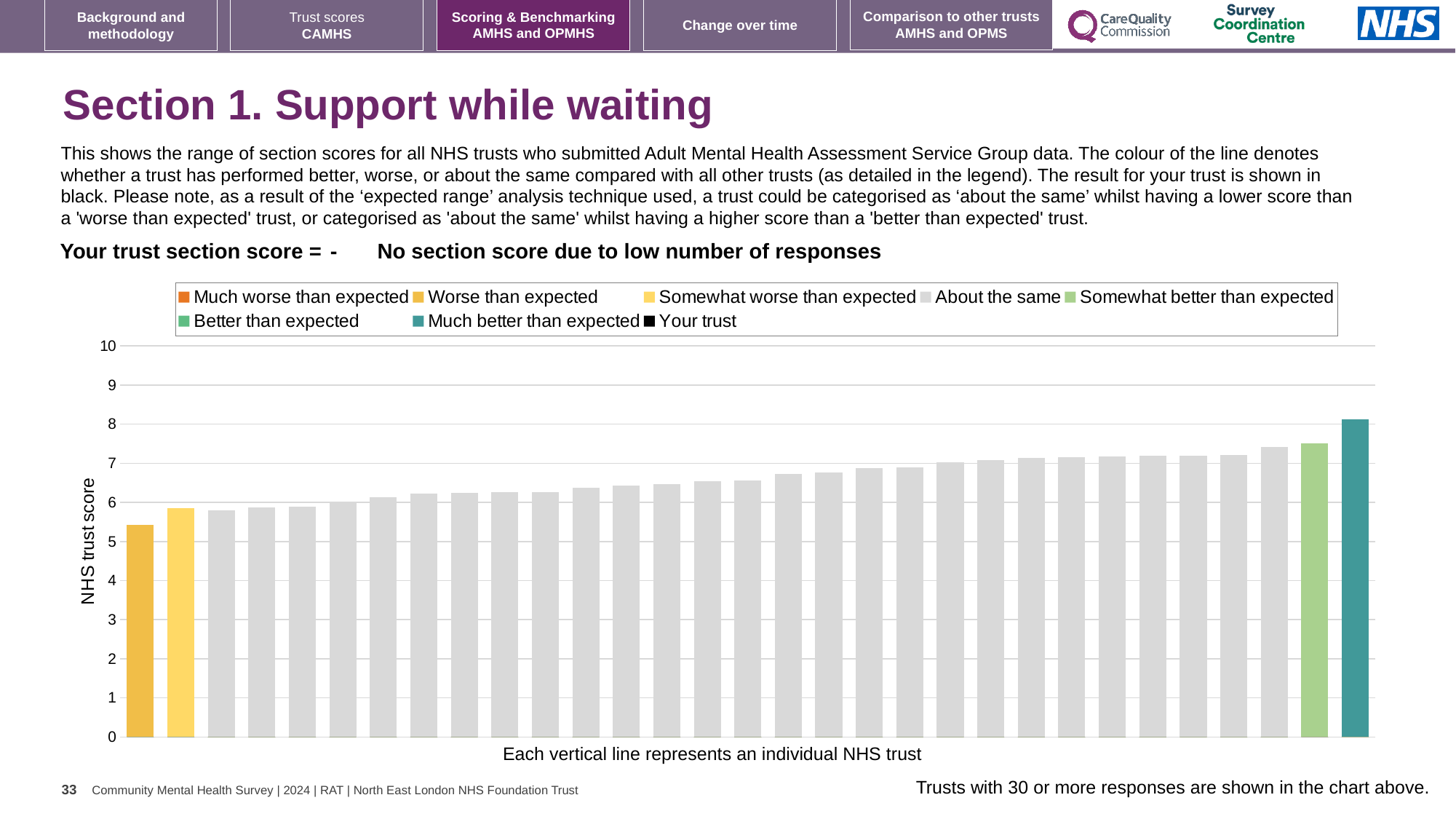
Which legend category does the shortest bar in the chart belong to? Worse than expected What kind of chart is shown on the slide? Bar chart Is the value of the tallest bar greater or less than 9? less Do the bar heights rise or fall from left to right across the chart? Rise Which legend category does the tallest bar in the chart belong to? Much better than expected Which is taller: the 'Somewhat better than expected' bar or the 'Worse than expected' bar? Somewhat better than expected Is the value of the tallest bar greater or less than 7? greater Is the value of the leftmost bar greater or less than 5? greater How many entries does the chart legend list? 8 What is the label on the vertical axis of the chart? NHS trust score What is the highest value shown on the vertical axis of the chart? 10